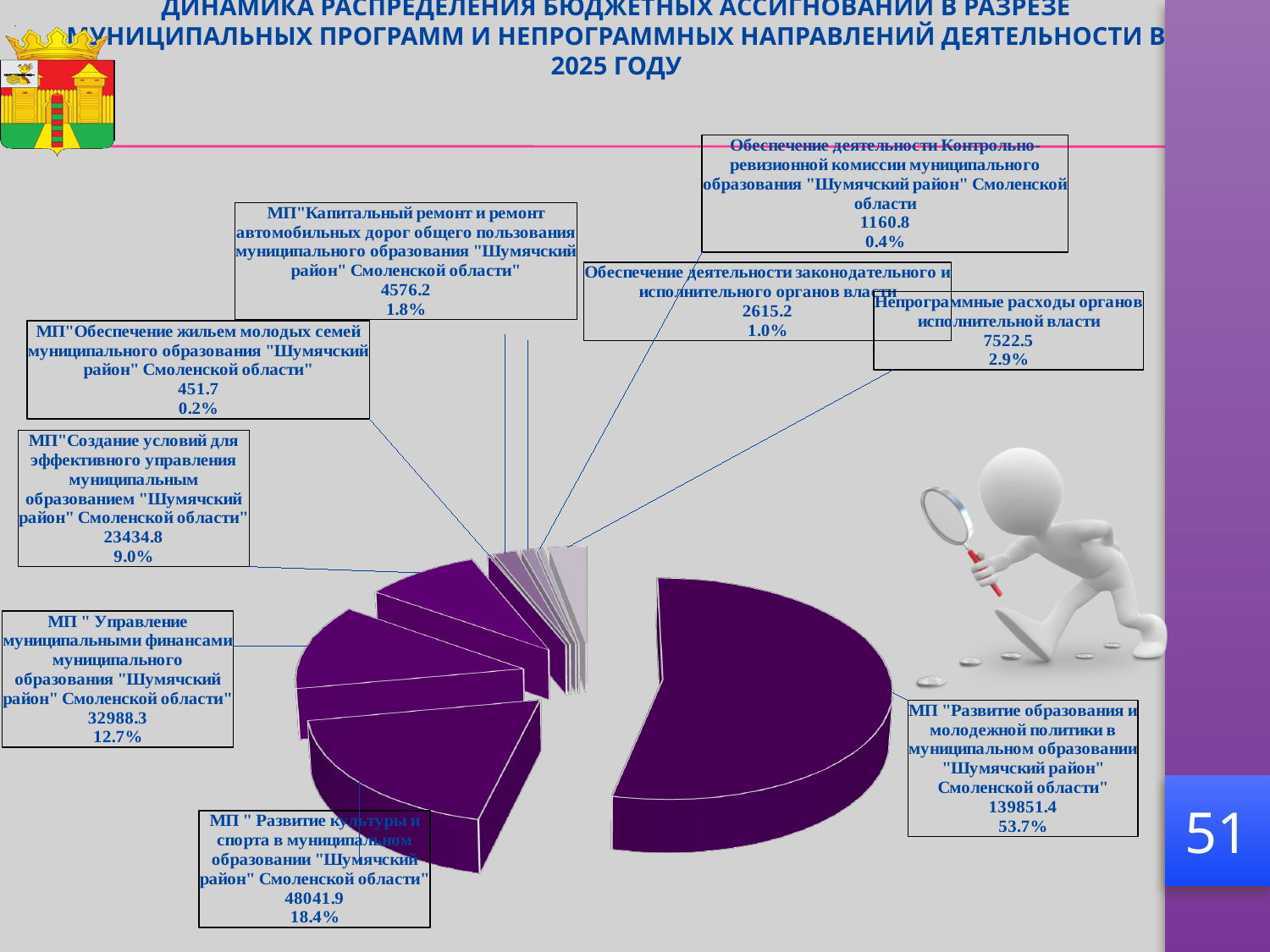
Which category has the smallest share of the pie? МП "Обеспечение жильем молодых семей муниципального образования "Шумячский район" Смоленской области" What share of the pie does МП "Управление муниципальными финансами" have? 12.7% How many slices (categories) does the pie chart have? 9 What value is shown for МП "Развитие культуры и спорта"? 48041.9 Which is larger: the value for МП "Создание условий для эффективного управления" or the value for МП "Капитальный ремонт и ремонт автомобильных дорог"? МП "Создание условий для эффективного управления" What year does the chart title refer to? 2025 What is the difference between the values for МП "Развитие образования и молодежной политики" (139851.4) and МП "Развитие культуры и спорта" (48041.9)? 91809.5 Which category has the largest share of the pie? МП "Развитие образования и молодежной политики в муниципальном образовании "Шумячский район" Смоленской области" What share of the pie does МП "Развитие образования и молодежной политики" have? 53.7% What kind of chart is shown on the slide? pie chart What percentage is shown for Обеспечение деятельности Контрольно-ревизионной комиссии? 0.4% What value is shown for Непрограммные расходы органов исполнительной власти? 7522.5